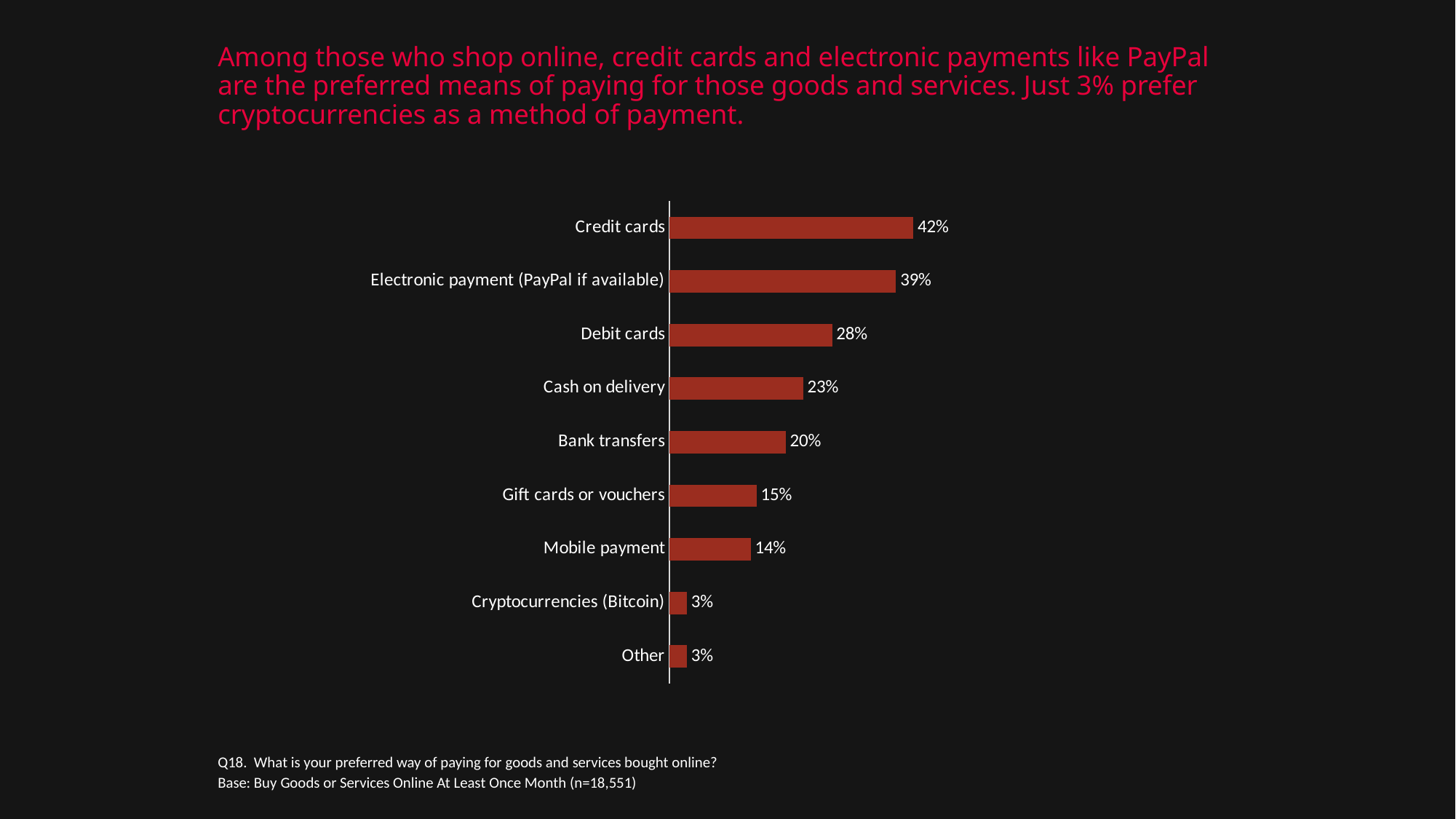
What is the value shown for Electronic payment (PayPal if available)? 39% How many payment method categories are shown in the chart? 9 What percentage prefer Cash on delivery? 23% Which is larger, the value for Debit cards or the value for Cash on delivery? Debit cards What percentage of online shoppers prefer credit cards as a payment method? 42% What type of chart is shown on the slide? Bar chart What value is shown for Cryptocurrencies (Bitcoin)? 3% What is the sample size (n) given in the base note below the chart? 18,551 What is the difference between the values for Credit cards and Debit cards? 14% What is the value for Mobile payment? 14% Which payment method has the highest percentage? Credit cards What is the difference between Bank transfers and Gift cards or vouchers? 5%